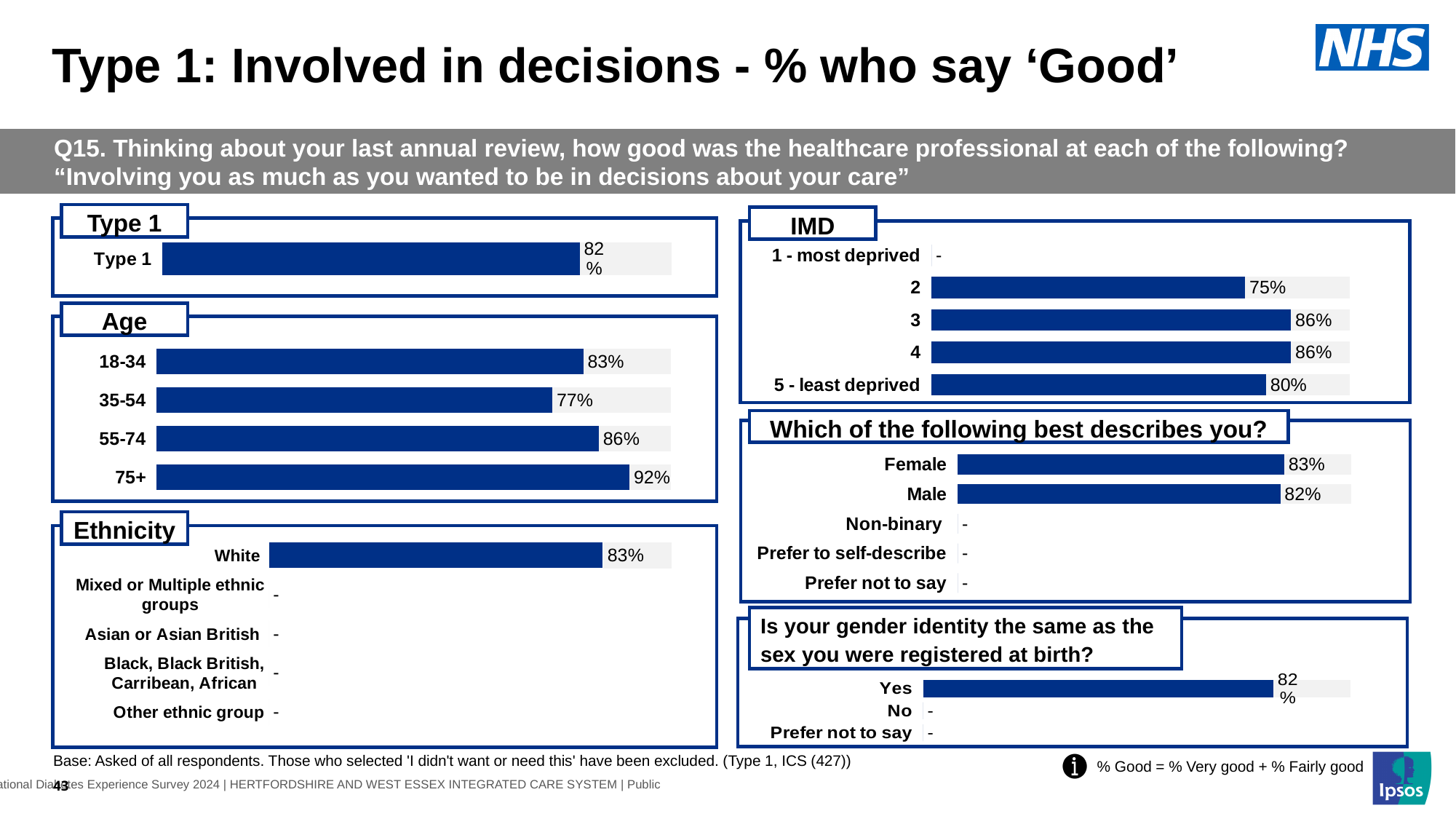
In the Ethnicity chart, what is the value for White? 83% In the 'Is your gender identity the same as the sex you were registered at birth?' chart, what is the value for Yes? 82% In the IMD chart, what is the value for 2? 75% In the Type 1 chart, what is the value for Type 1? 82% In the Age chart, what is the value for 75+? 92% In the IMD chart, what is the value for 5 - least deprived? 80% What type of chart is used in the Age section? Bar chart In the IMD chart, how many categories are listed? 5 In the Age chart, which age group has the lowest value? 35-54 In the 'Which of the following best describes you?' chart, what is the value for Male? 82% In the Age chart, what is the difference between the values for 75+ and 35-54? 15 percentage points In the 'Which of the following best describes you?' chart, which is larger, Female or Male? Female